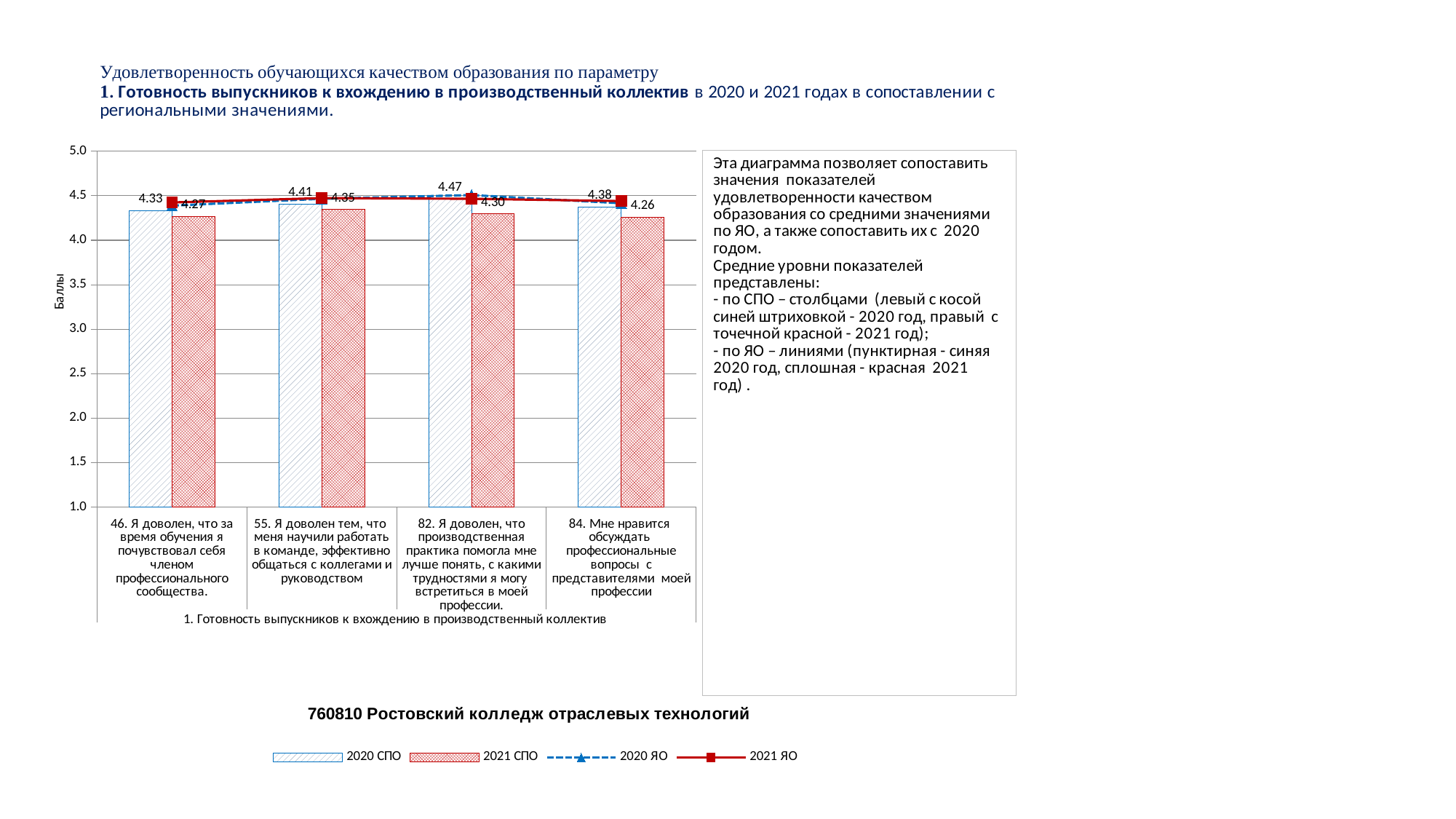
What is the difference between the 2020 СПО and 2021 СПО values for question 82? 0.17 How many series does the legend list? 4 Which is larger: the 2020 СПО value for question 55 or for question 84? Question 55 (4.41) Is the 2021 ЯО line value for question 46 greater or less than 4.0? greater How many questions (categories) are shown on the x axis? 4 What is the 2021 СПО value for question 84 (Мне нравится обсуждать профессиональные вопросы...)? 4.26 What is the difference between the 2020 СПО and 2021 СПО values for question 84? 0.12 What is the 2020 СПО value for question 46 (Я доволен, что за время обучения я почувствовал себя членом профессионального сообщества)? 4.33 Which question has the lowest 2021 СПО value? 84. Мне нравится обсуждать профессиональные вопросы с представителями моей профессии What is the 2021 СПО value for question 82 (производственная практика помогла мне лучше понять...)? 4.30 Which question has the highest 2020 СПО value? 82. Я доволен, что производственная практика помогла мне лучше понять, с какими трудностями я могу встретиться в моей профессии. What is the title of the vertical axis? Баллы